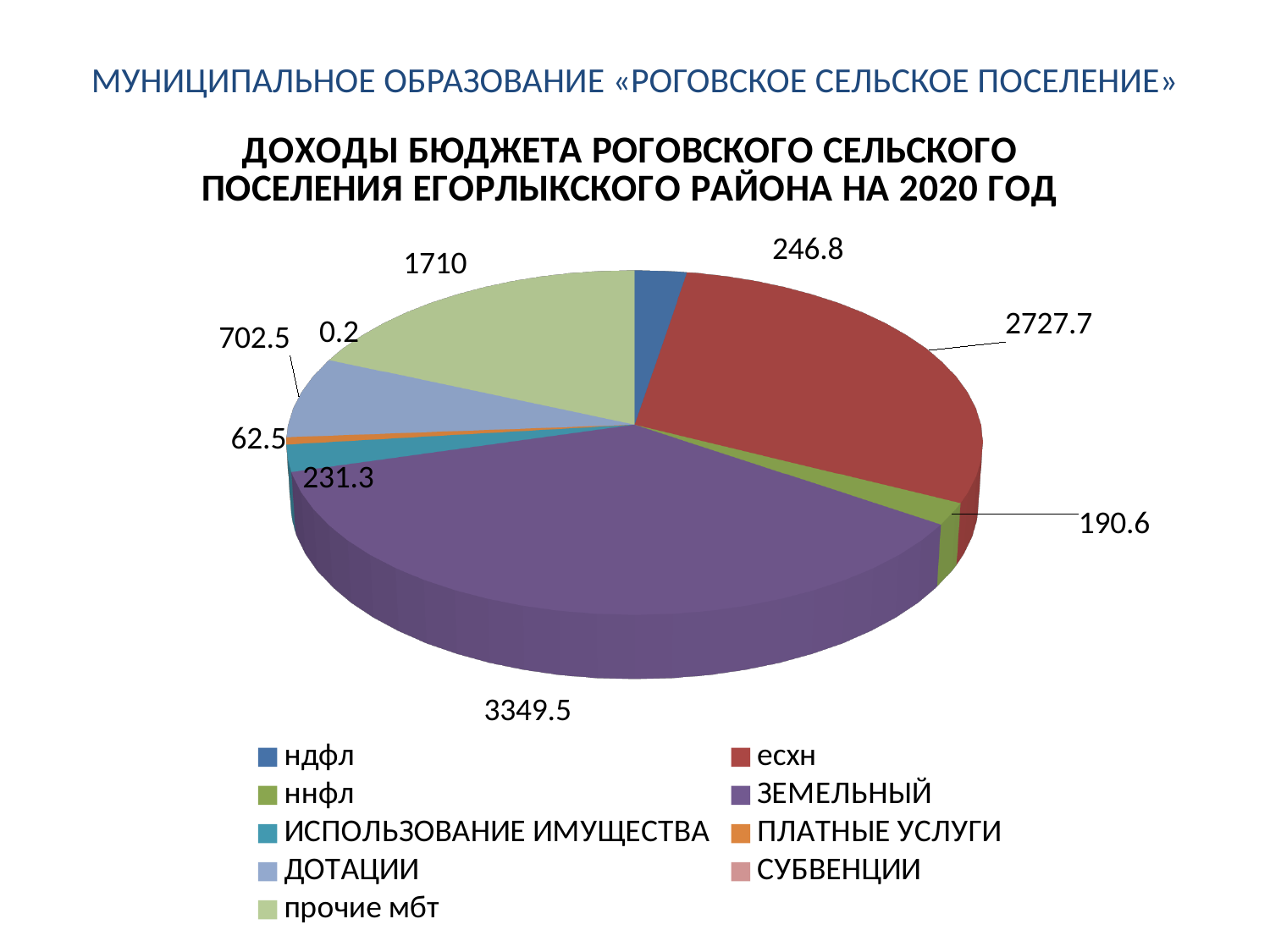
What is the value for есхн? 2727.7 What kind of chart is shown on the slide? Pie chart How many categories does the legend list? 9 Which category has the lowest value? СУБВЕНЦИИ What is the value for прочие мбт? 1710 Which is larger, the value for ндфл or the value for ннфл? ндфл What is the value for ЗЕМЕЛЬНЫЙ? 3349.5 What colour is the slice for ЗЕМЕЛЬНЫЙ? Purple What is the value for ДОТАЦИИ? 702.5 What is the difference between the values for ЗЕМЕЛЬНЫЙ and есхн? 621.8 What is the value for ПЛАТНЫЕ УСЛУГИ? 62.5 Which category has the highest value? ЗЕМЕЛЬНЫЙ